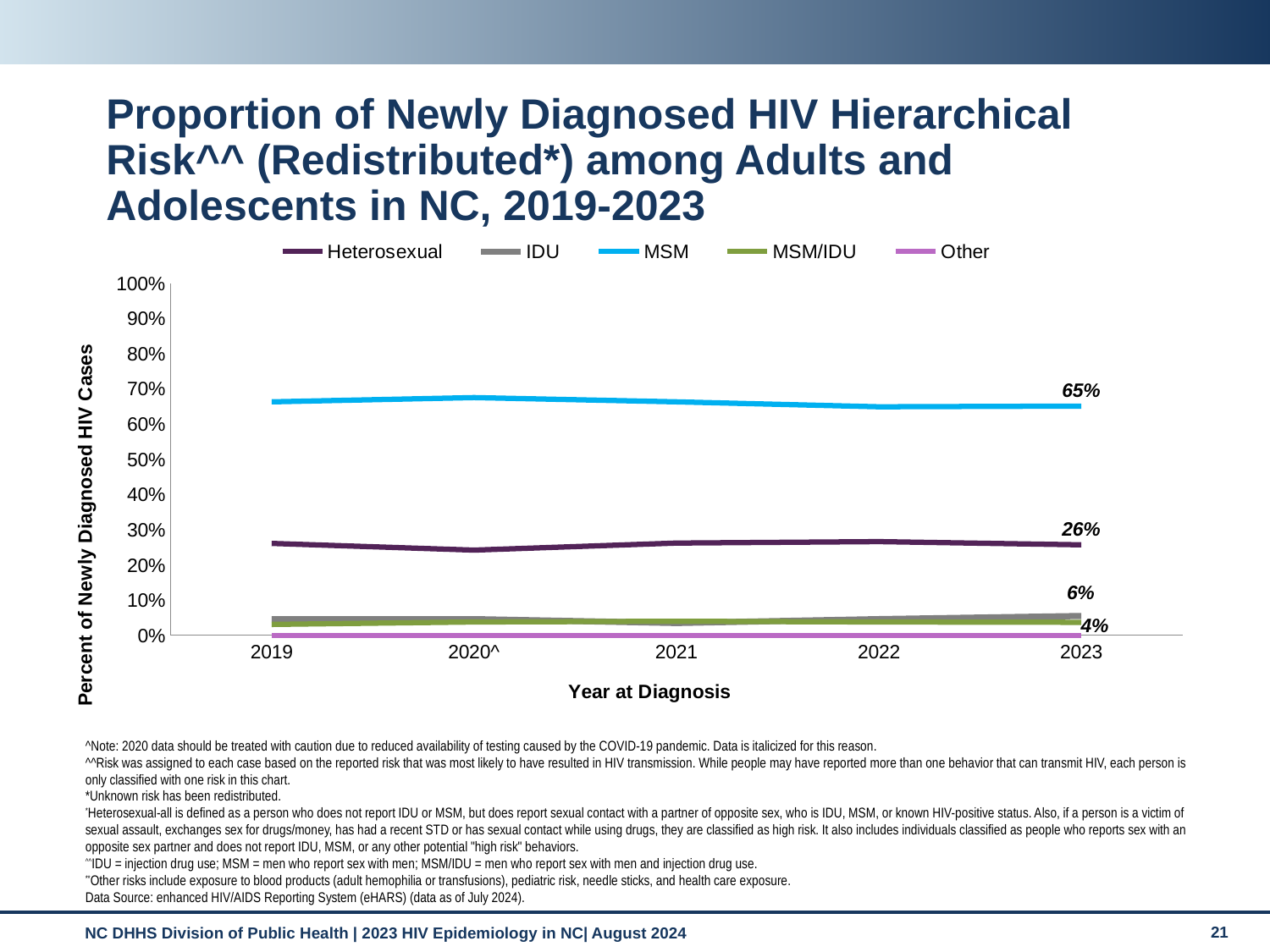
Which risk category has the lowest proportion in 2023? Other Which is larger in 2023, Heterosexual or IDU? Heterosexual What is the value for Heterosexual in 2023? 26% How many years are shown on the x axis? 5 Is the value for Heterosexual in 2020^ greater or less than 30%? less Is the value for MSM in 2019 greater or less than 50%? greater What is the difference between the MSM and Heterosexual values in 2023? 39% What kind of chart is shown on the slide? line chart What is the title of the x axis? Year at Diagnosis How many series does the legend list? 5 Which risk category has the highest proportion in 2023? MSM What is the value for MSM in 2023? 65%